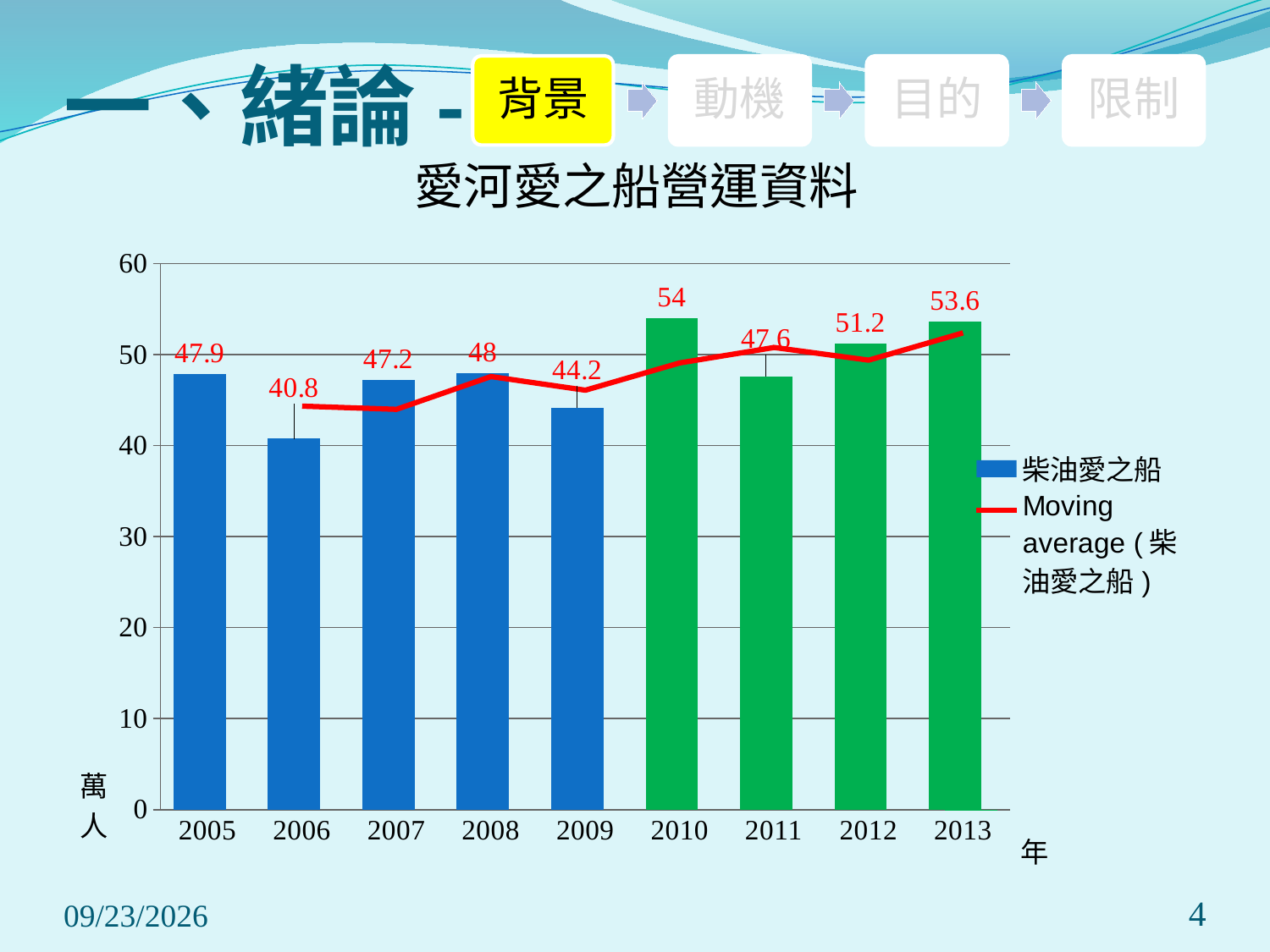
What is the value for 2006 in the 愛河愛之船營運資料 chart? 40.8 Is the value for 2009 in the 愛河愛之船營運資料 chart greater or less than 50? less Which is larger in the 愛河愛之船營運資料 chart, the value for 2012 or the value for 2011? 2012 What is the value for 2013 in the 愛河愛之船營運資料 chart? 53.6 What is the value for 2010 in the 愛河愛之船營運資料 chart? 54 What is the difference between the values for 2010 and 2006 in the 愛河愛之船營運資料 chart? 13.2 What is the unit label on the y axis of the 愛河愛之船營運資料 chart? 萬人 How many series does the legend of the 愛河愛之船營運資料 chart list? 2 Which year has the lowest value in the 愛河愛之船營運資料 chart? 2006 How many years are shown on the x axis of the 愛河愛之船營運資料 chart? 9 What kind of chart is the 愛河愛之船營運資料 chart? Bar chart with a moving average line Which year has the highest value in the 愛河愛之船營運資料 chart? 2010